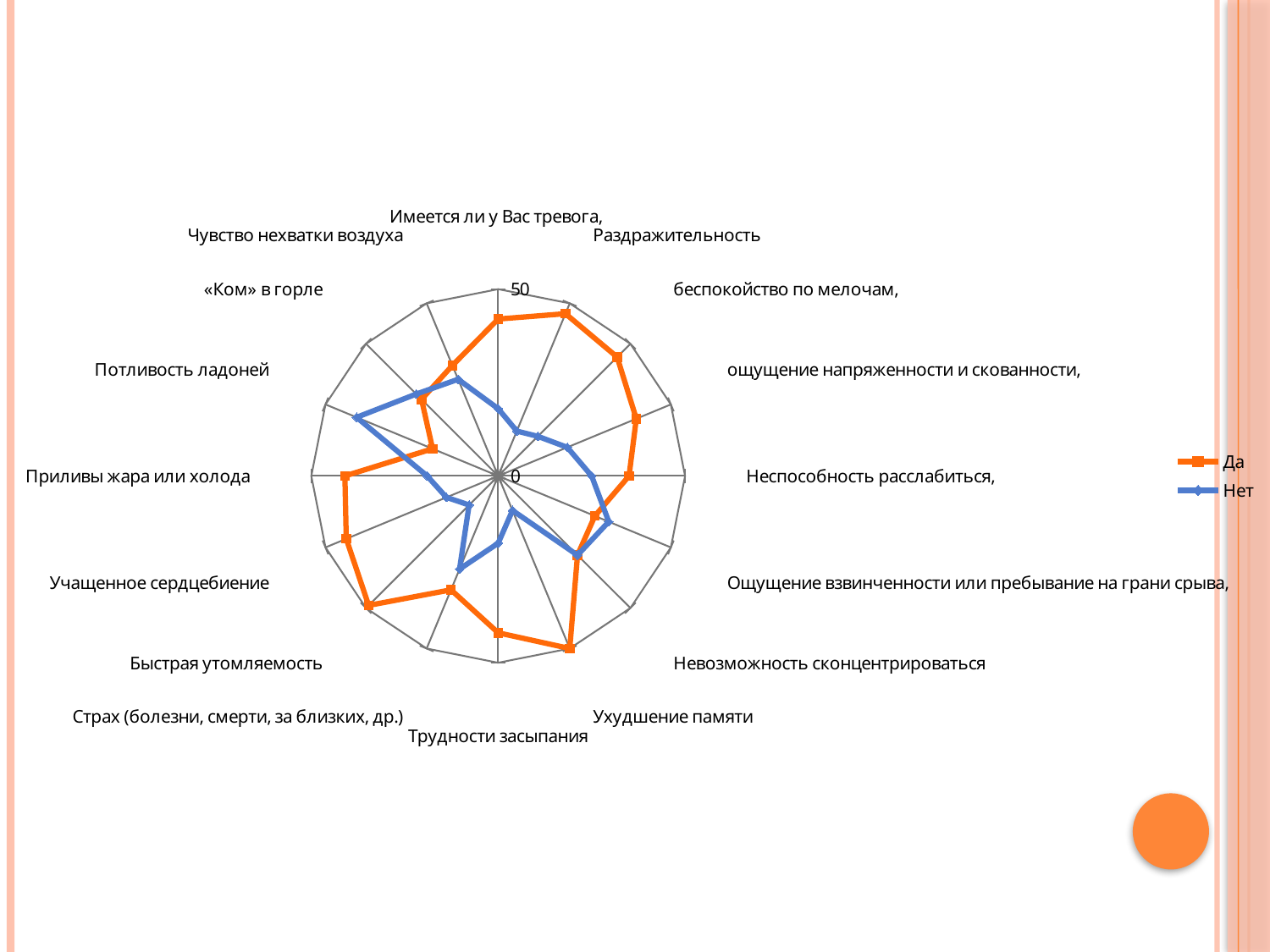
For Приливы жара или холода, which series has the larger value, Да or Нет? Да What colour is the line for the series Да? Orange How many series does the legend list? 2 For Раздражительность, which series has the larger value, Да or Нет? Да What are the two series named in the legend? Да and Нет What kind of chart is shown on the slide? Radar chart Is the value of Нет for Потливость ладоней greater or less than 50? less How many categories (axes) does the radar chart have? 16 For Учащенное сердцебиение, which series has the larger value, Да or Нет? Да Is the value of Да for Раздражительность greater or less than 50? less